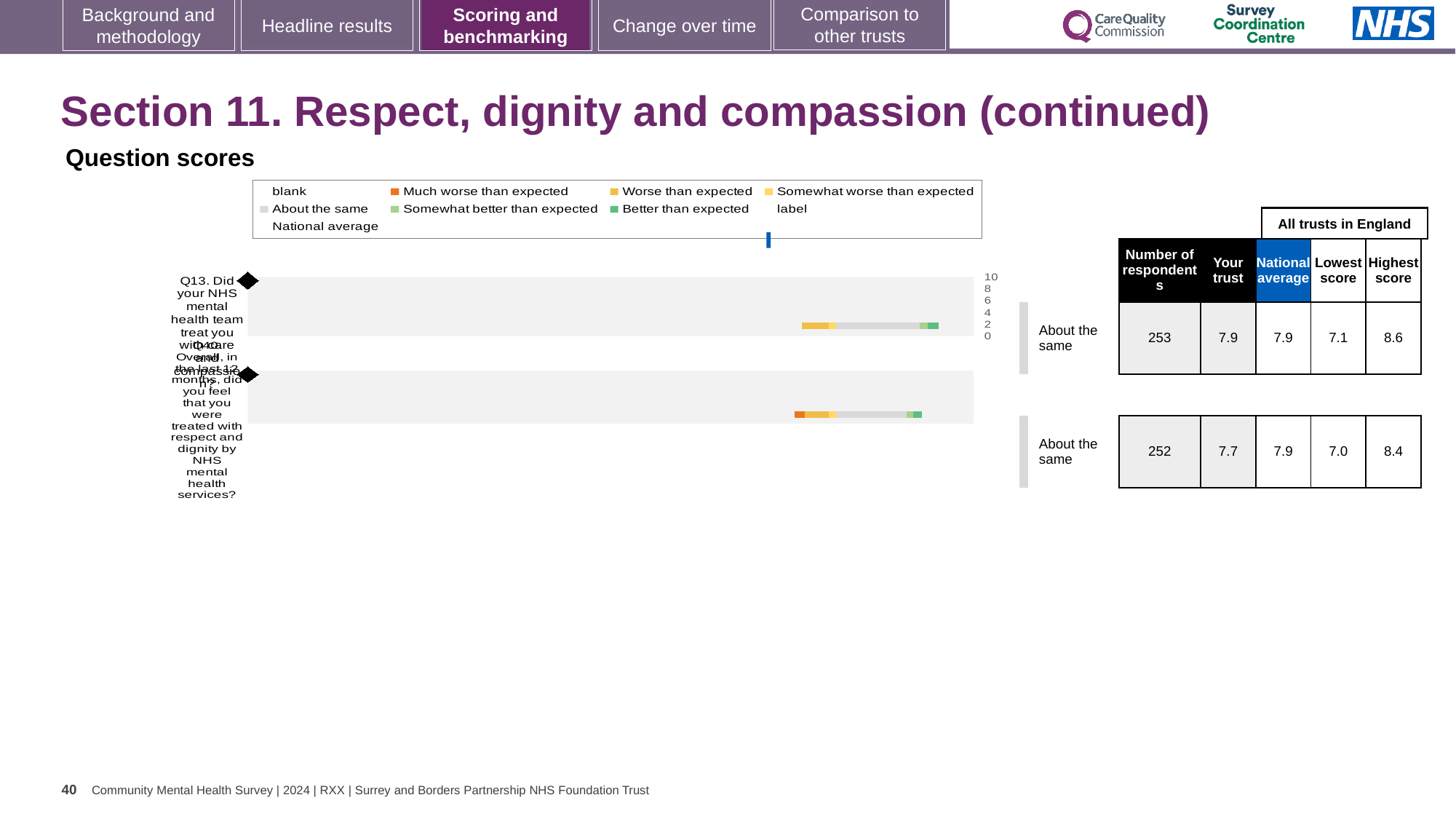
What is the national average score for Q13? 7.9 What is the number of respondents for Q13 in the table next to the chart? 253 What is the difference between the highest and lowest scores for Q13? 1.5 What is the lowest score among all trusts in England for Q13? 7.1 What is the difference between the 'Your trust' score and the national average for Q14? 0.2 What benchmark category is shown for Q14 next to the chart? About the same What is the 'Your trust' score for Q14 in the table next to the chart? 7.7 What is the highest score among all trusts in England for Q14? 8.4 Which question has the higher 'Your trust' score, Q13 or Q14? Q13 How many questions (categories) are plotted in the question scores chart? 2 Which legend entry is shown in orange in the question scores chart? Much worse than expected What kind of chart is used to show the question scores on this slide? bar chart